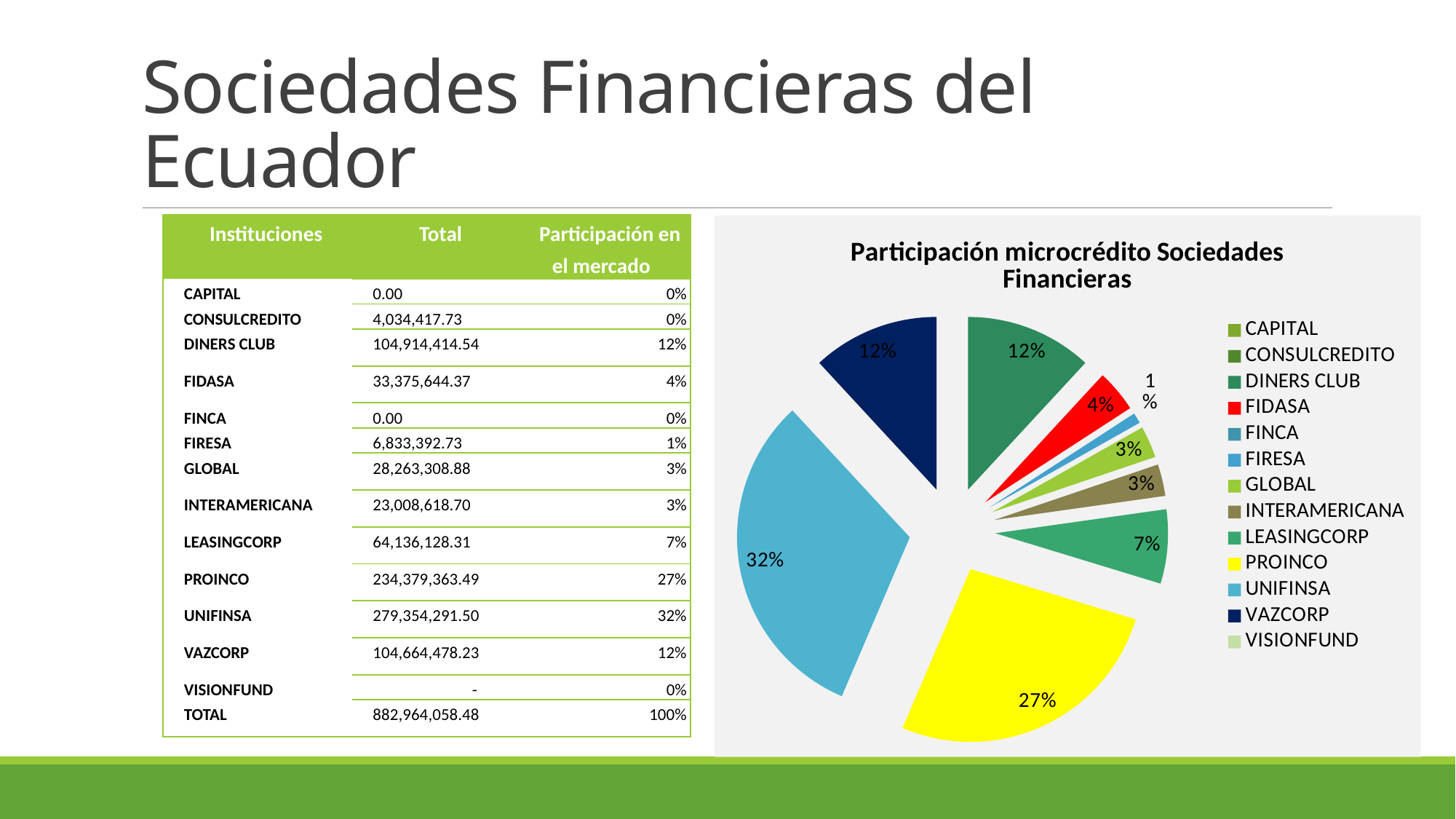
What is the difference in percentage points between the UNIFINSA slice and the PROINCO slice? 5% Which is larger in the pie chart, the slice for PROINCO or the slice for LEASINGCORP? PROINCO What percentage is shown for FIDASA in the pie chart? 4% How many entries does the chart's legend list? 13 What is the title of the chart? Participación microcrédito Sociedades Financieras Which colour represents PROINCO in the pie chart? yellow What type of chart is shown on the slide? pie chart What share of the pie does UNIFINSA hold? 32% What percentage is shown for GLOBAL in the pie chart? 3% What share of the pie does PROINCO hold? 27% What percentage is shown for LEASINGCORP in the pie chart? 7% Which institution has the largest slice of the pie? UNIFINSA